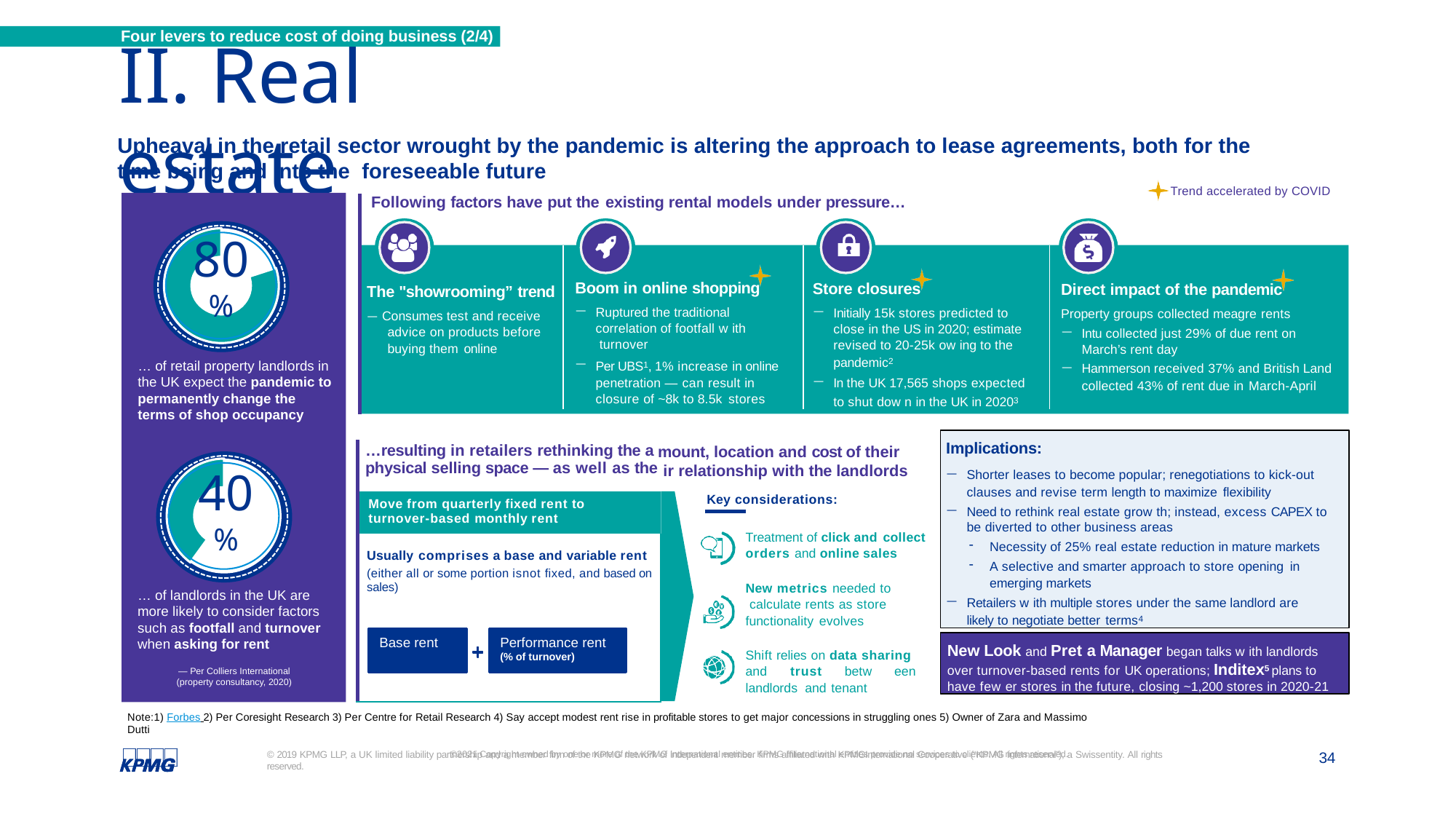
What source is cited beneath the two donut charts on the left of the slide? Per Colliers International (property consultancy, 2020) In the top donut chart, what share of retail property landlords in the UK expect the pandemic to permanently change the terms of shop occupancy? 80% Is the value shown in the bottom donut chart greater or less than 50%? less Which of the two donut charts on the left shows the larger value, the top one or the bottom one? The top one How many donut charts are shown on the left side of the slide? 2 What percentage is shown in the bottom donut chart on the left of the slide? 40% In the bottom donut chart, what share of landlords in the UK are more likely to consider factors such as footfall and turnover when asking for rent? 40% What kind of chart is used to show the 80% figure on the left of the slide? Donut (pie) chart Is the value shown in the top donut chart greater or less than 50%? greater What colour is the filled portion of the donut charts on the left of the slide? Teal What is the difference in percentage points between the top donut chart (80%) and the bottom donut chart (40%)? 40 percentage points What percentage is shown in the top donut chart on the left of the slide? 80%